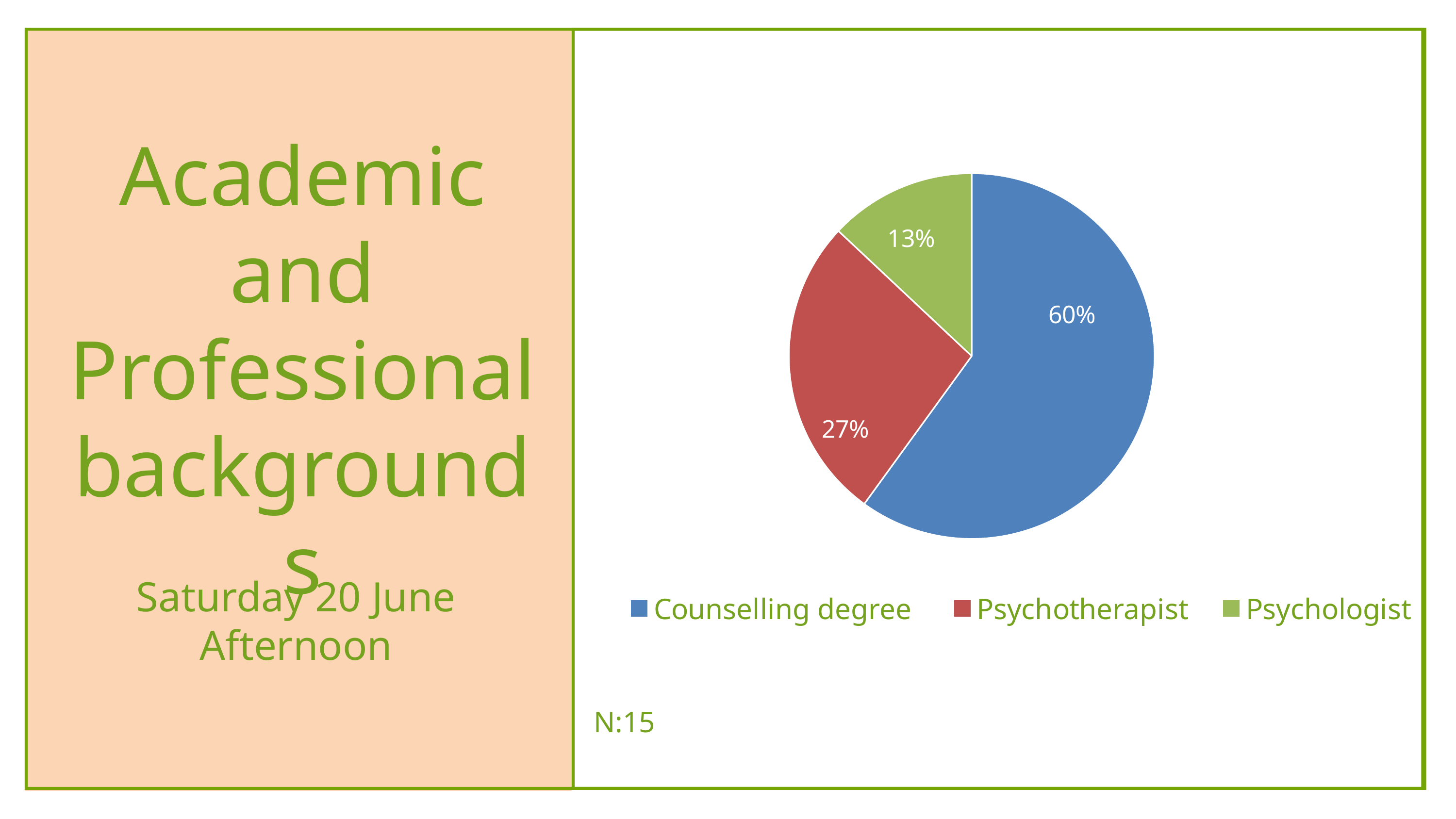
What sample size (N) is stated below the pie chart? 15 What percentage of the pie chart is Psychotherapist? 27% What percentage of the pie chart is Psychologist? 13% What percentage of the pie chart is Counselling degree? 60% What kind of chart is shown on the slide? Pie chart What is the difference in percentage points between Counselling degree and Psychotherapist? 33 What is the difference in percentage points between Psychotherapist and Psychologist? 14 Which category has the smallest share of the pie chart? Psychologist How many categories are shown in the pie chart? 3 Which category has the largest share of the pie chart? Counselling degree Which is larger, the share for Psychotherapist or the share for Psychologist? Psychotherapist What colour is the Psychotherapist slice in the pie chart? Red